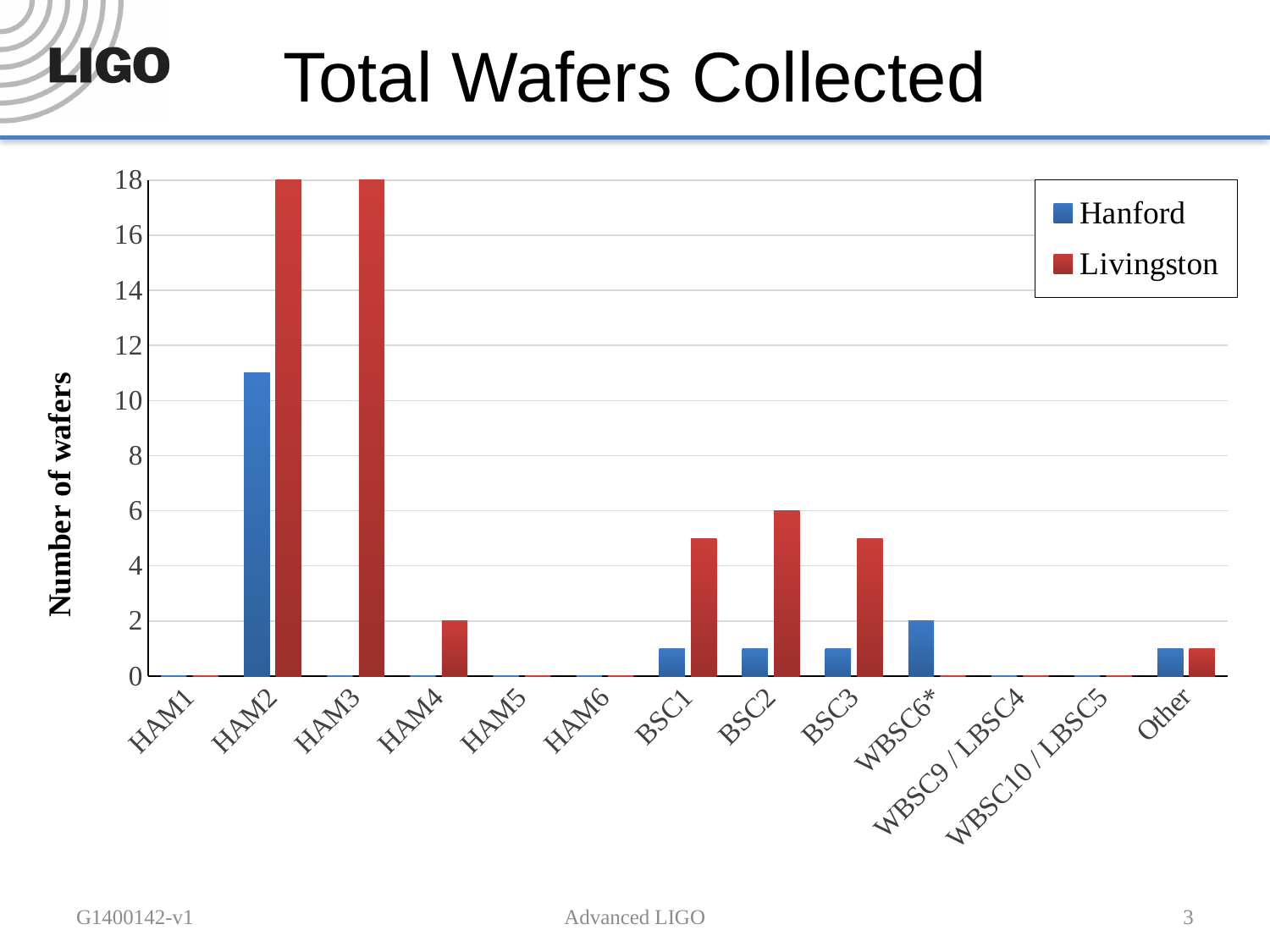
What type of chart is shown on the slide? bar chart What is the Livingston value for BSC2? 6 What is the Livingston value for HAM4? 2 What is the Hanford value for WBSC6*? 2 How many series does the legend list? 2 Which category has the highest Hanford value? HAM2 Is the Hanford value for HAM2 greater or less than 10? greater What is the Livingston value for HAM2? 18 What is the difference between the Livingston values for HAM3 and HAM4? 16 For HAM2, which series has the larger value, Hanford or Livingston? Livingston What is the Livingston value for HAM3? 18 How many categories are shown on the x axis? 13